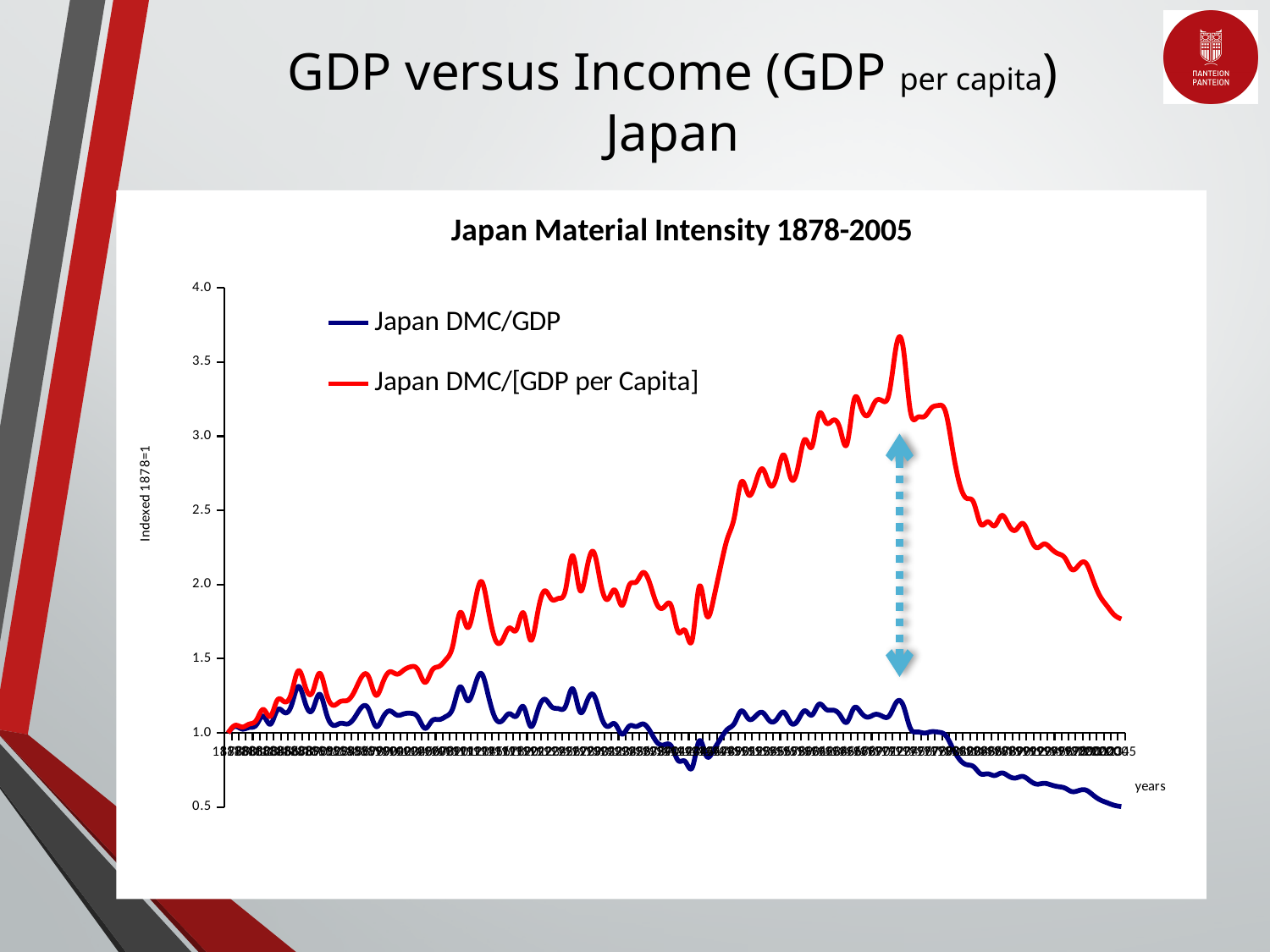
What is the title of the chart? Japan Material Intensity 1878-2005 Is the value of the Japan DMC/GDP series at the end of the period (2005) greater or less than 1.0? less Is the value of the Japan DMC/[GDP per Capita] series at the end of the period (2005) greater or less than 1.5? greater Which series reaches the higher peak value, Japan DMC/GDP or Japan DMC/[GDP per Capita]? Japan DMC/[GDP per Capita] How many series does the legend list? 2 What is the label on the vertical axis of the chart? Indexed 1878=1 What is the highest value shown on the vertical axis? 4.0 What kind of chart is shown on the slide? Line chart Is the peak value of the Japan DMC/GDP series greater or less than 1.5? less Does the Japan DMC/GDP series end higher or lower than it starts? Lower Which series has the higher value at the end of the period, Japan DMC/GDP or Japan DMC/[GDP per Capita]? Japan DMC/[GDP per Capita]